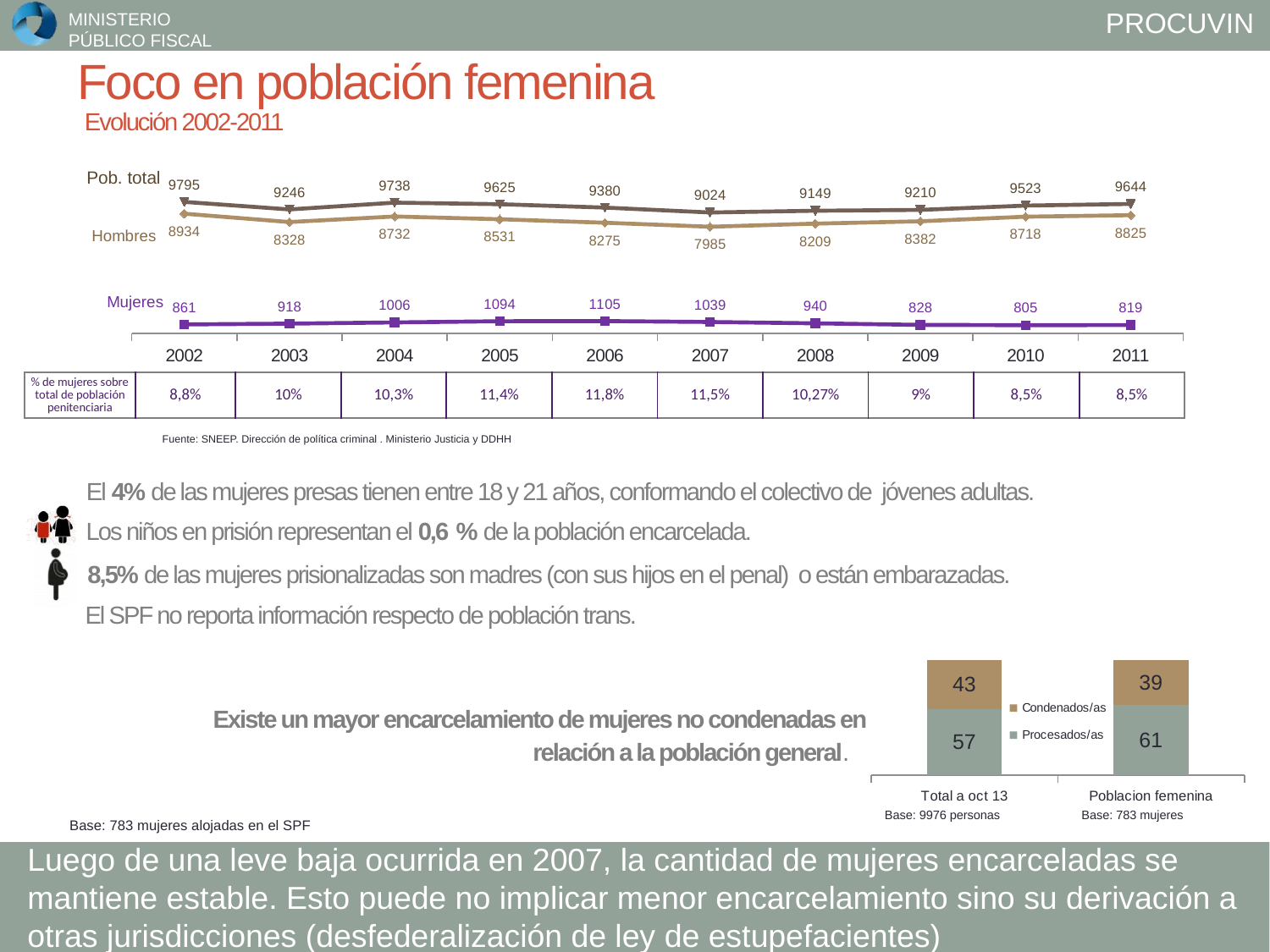
In the line chart 'Evolución 2002-2011', what is the difference between the Mujeres values in 2005 and 2002? 233 In the line chart 'Evolución 2002-2011', in which year is the Mujeres value highest? 2006 In the line chart 'Evolución 2002-2011', in which year is the Mujeres value lowest? 2010 In the line chart 'Evolución 2002-2011', how many years are shown on the x axis? 10 In the line chart 'Evolución 2002-2011', in which year is the Hombres value lowest? 2007 In the stacked bar chart at the bottom right, which bar has the larger Condenados/as value, Total a oct 13 or Poblacion femenina? Total a oct 13 In the line chart 'Evolución 2002-2011', what is the value for Mujeres in 2006? 1105 In the line chart 'Evolución 2002-2011', how many series are plotted? 3 In the line chart 'Evolución 2002-2011', what is the value for Hombres in 2007? 7985 What kind of chart is shown at the bottom right of the slide? Stacked bar chart In the line chart 'Evolución 2002-2011', what is the Pob. total value in 2011? 9644 In the stacked bar chart at the bottom right, what is the Procesados/as value for Poblacion femenina? 61